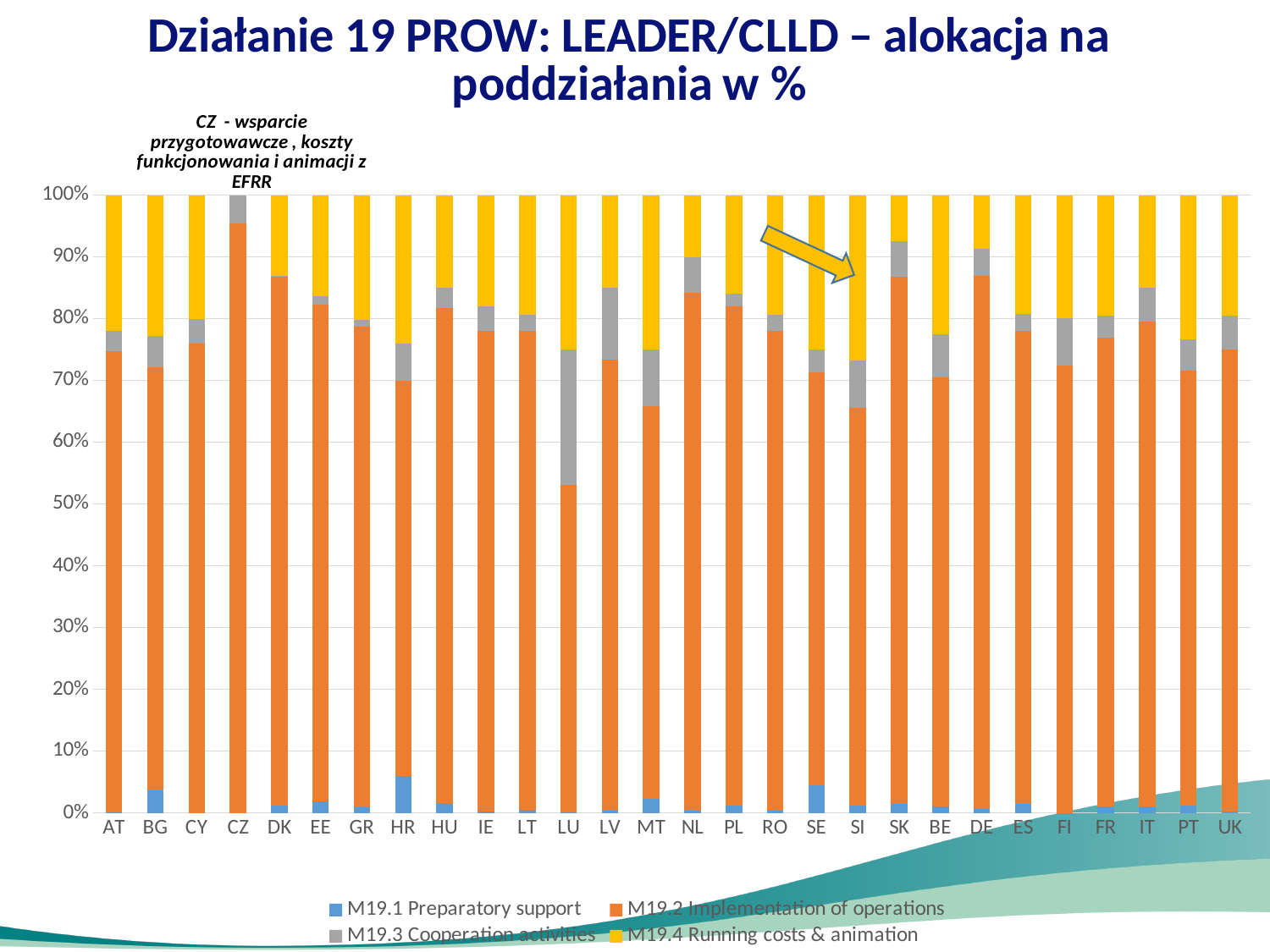
How many series does the legend list? 4 Is the top of the M19.2 Implementation of operations segment for CZ greater or less than 90%? greater Which country has the largest M19.3 Cooperation activities segment? LU Is the top of the M19.2 Implementation of operations segment for MT greater or less than 70%? less Which country has the largest M19.1 Preparatory support segment? HR Which country has the smallest M19.4 Running costs & animation segment? CZ Which is larger, the M19.2 Implementation of operations segment for CZ or for LU? CZ How many countries are shown on the x axis? 28 What is the total height of each stacked bar? 100% Is the M19.1 Preparatory support value for HR greater or less than 10%? less What kind of chart is shown on the slide? stacked bar chart